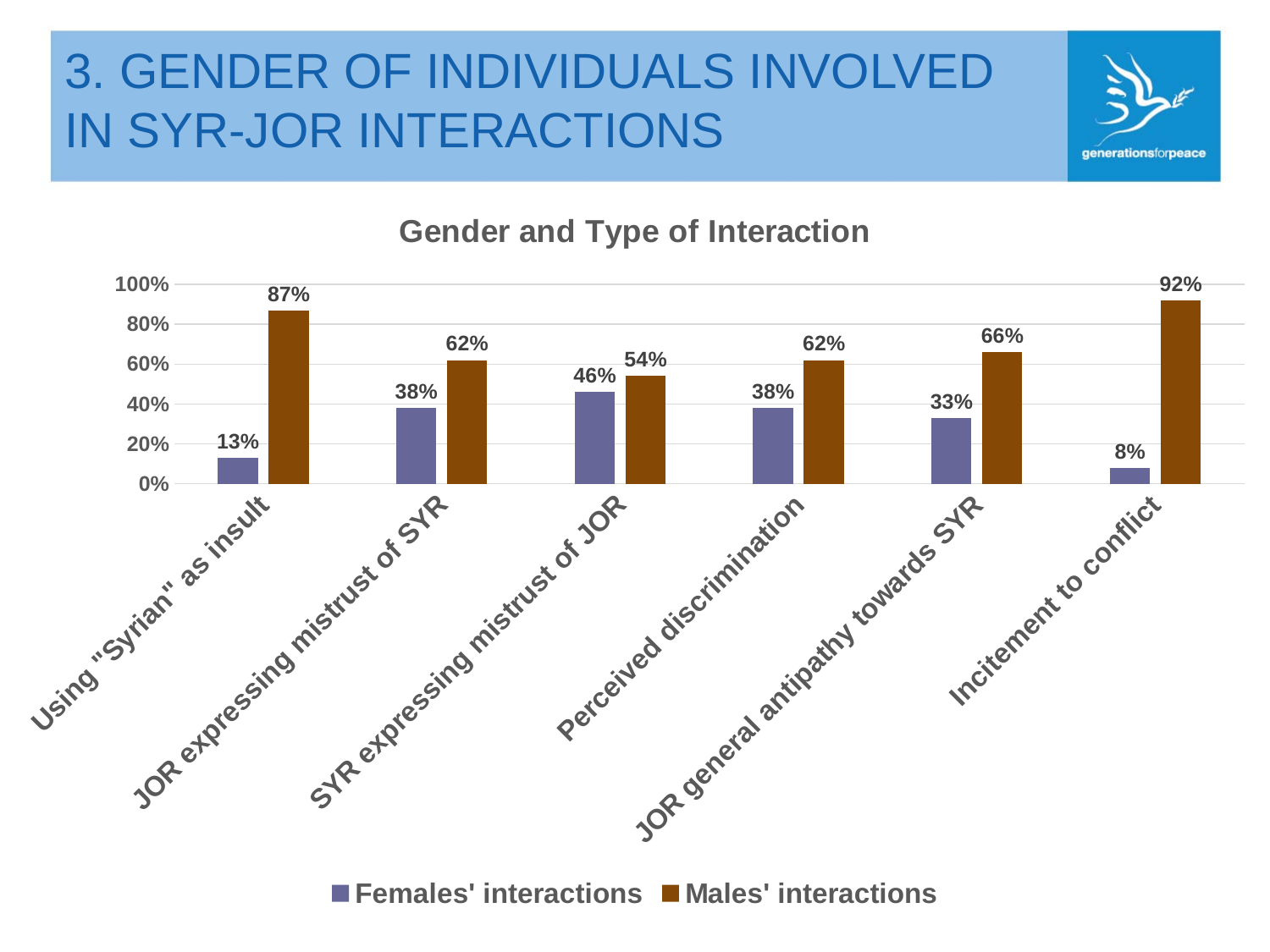
What is the value for Males' interactions for "Incitement to conflict"? 92% What kind of chart is shown on the slide? Bar chart What is the difference between Males' interactions and Females' interactions for "Using "Syrian" as insult"? 74% What is the title of the chart? Gender and Type of Interaction What is the value for Females' interactions for "Using "Syrian" as insult"? 13% What is the value for Males' interactions for "Perceived discrimination"? 62% Which is larger for "JOR general antipathy towards SYR": Females' interactions or Males' interactions? Males' interactions Which category has the lowest value for Females' interactions? Incitement to conflict How many series does the legend list? 2 How many categories are shown on the x axis? 6 Which category has the highest value for Males' interactions? Incitement to conflict What is the value for Females' interactions for "SYR expressing mistrust of JOR"? 46%